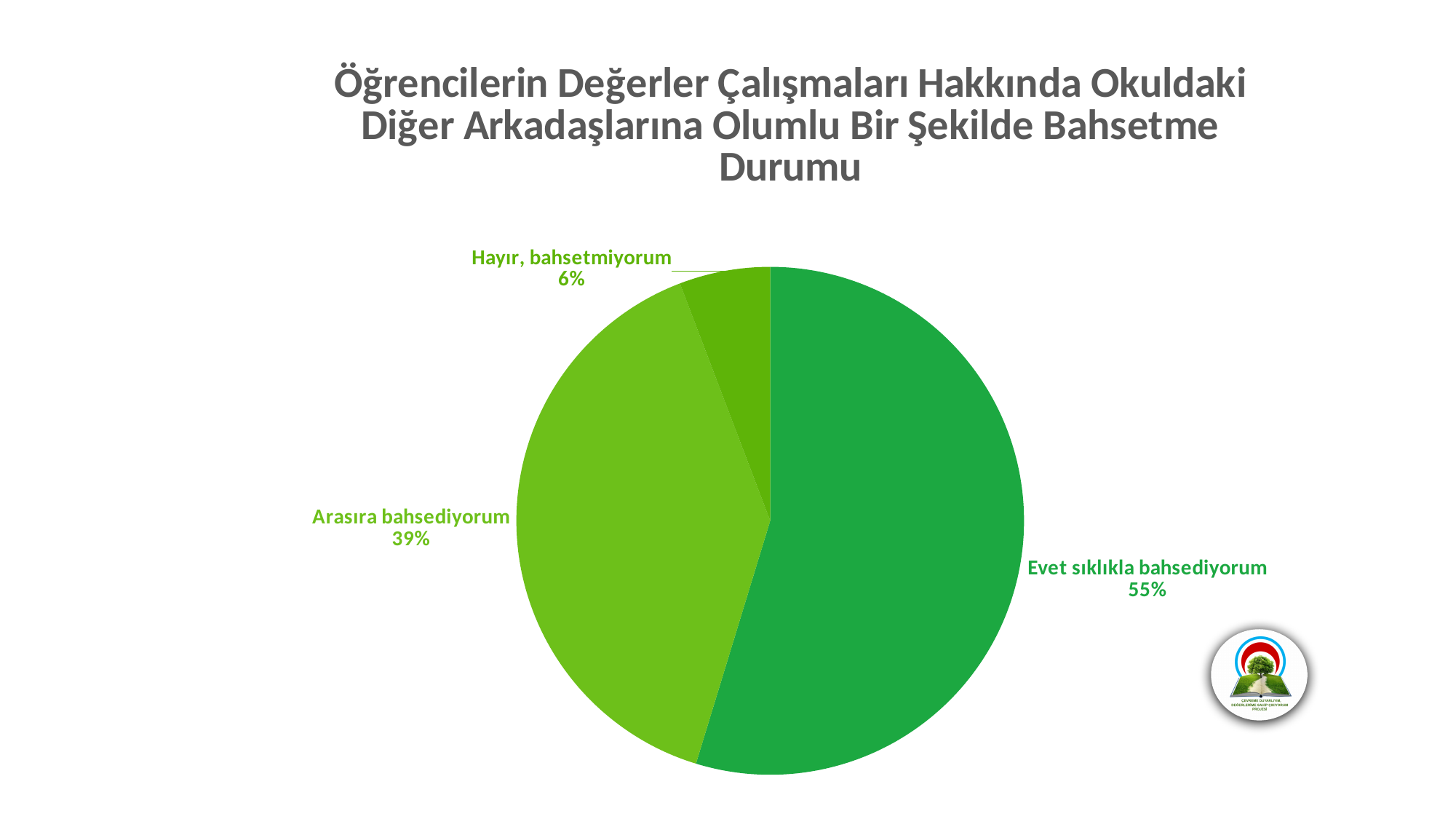
What is the title of the chart? Öğrencilerin Değerler Çalışmaları Hakkında Okuldaki Diğer Arkadaşlarına Olumlu Bir Şekilde Bahsetme Durumu Which is larger: the share for "Arasıra bahsediyorum" or the share for "Hayır, bahsetmiyorum"? Arasıra bahsediyorum How many slices does the pie chart have? 3 Which category has the smallest slice of the pie? Hayır, bahsetmiyorum What is the difference in percentage points between "Evet sıklıkla bahsediyorum" and "Arasıra bahsediyorum"? 16 What share of the pie does "Evet sıklıkla bahsediyorum" have? 55% Is the share for "Evet sıklıkla bahsediyorum" greater or less than 50%? greater What share of the pie does "Arasıra bahsediyorum" have? 39% What share of the pie does "Hayır, bahsetmiyorum" have? 6% What kind of chart is shown on the slide? pie chart What is the difference in percentage points between "Arasıra bahsediyorum" and "Hayır, bahsetmiyorum"? 33 Which category has the largest slice of the pie? Evet sıklıkla bahsediyorum